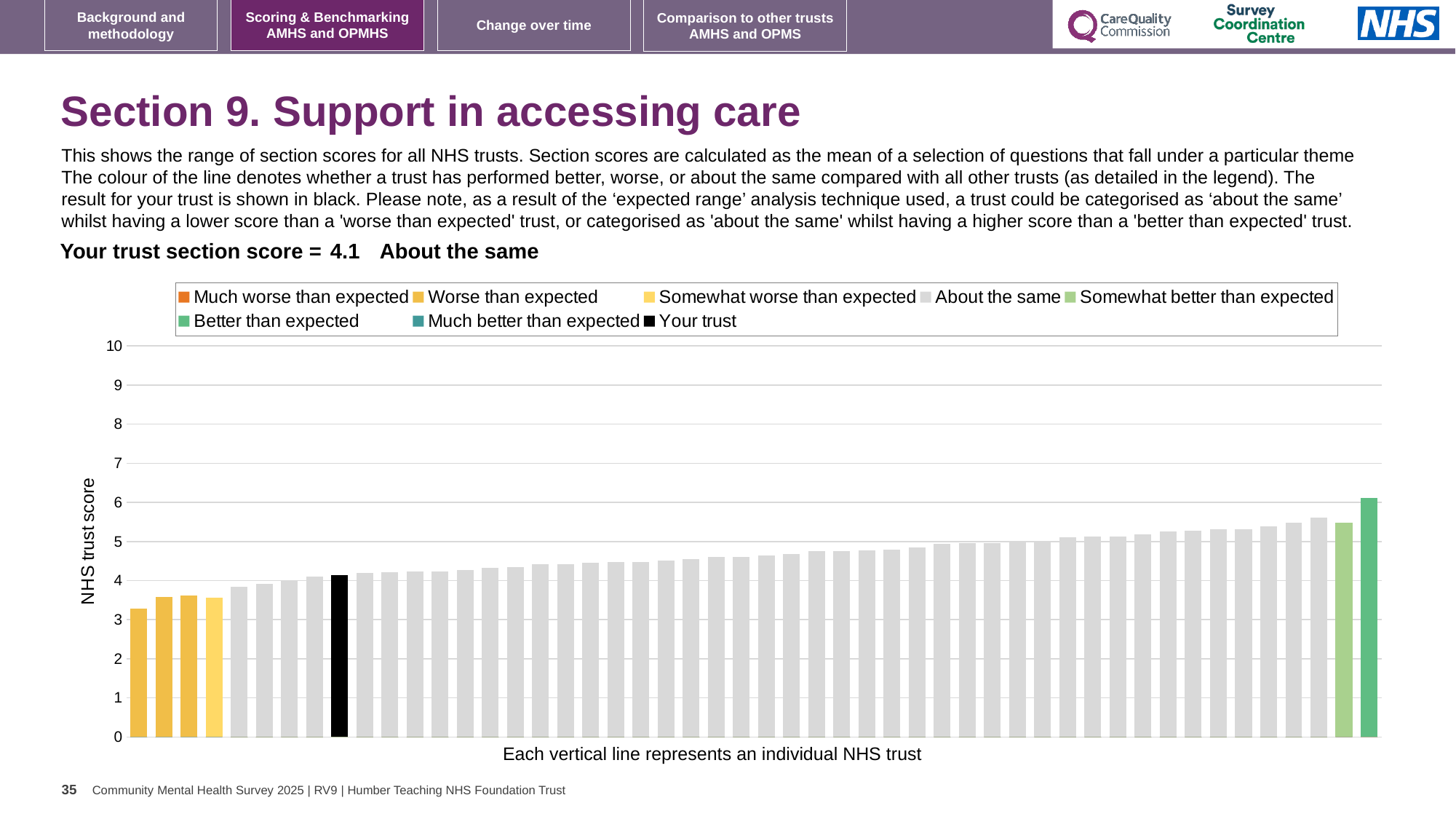
What kind of chart is shown on the slide? bar chart What is the label on the vertical axis of the chart? NHS trust score How many entries does the chart legend list? 8 Is the value of the black 'Your trust' bar greater or less than 4? greater How many bars are coloured as 'Worse than expected'? 3 What colour is used for the 'Your trust' bar in the chart? black Do the bar values rise or fall from left to right along the x axis? rise Which category is your trust placed in for this section? About the same Is the value of the tallest bar greater or less than 7? less What is the section score for your trust? 4.1 Is the value of the shortest bar greater or less than 4? less